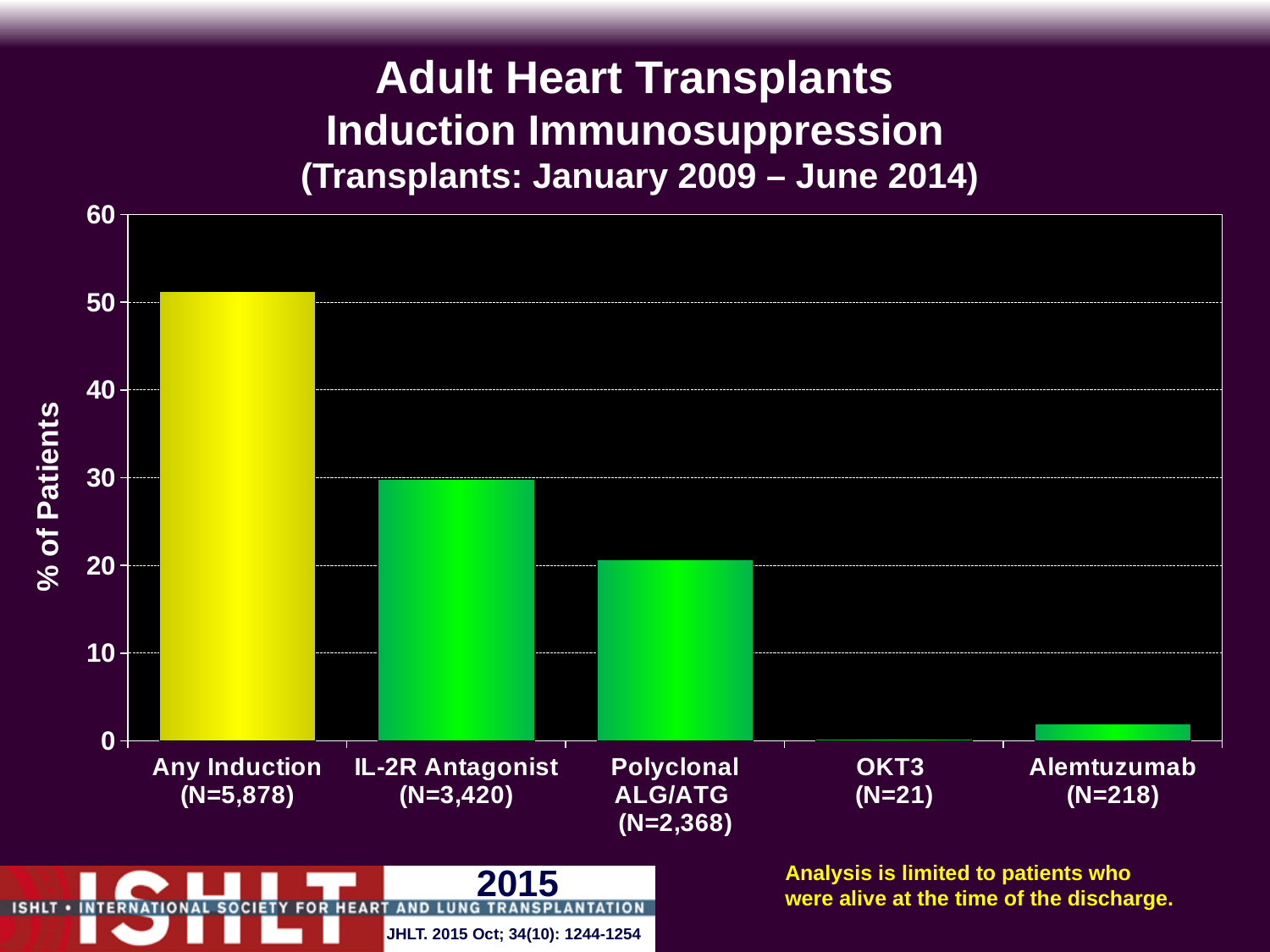
What kind of chart is shown on the slide? bar chart Is the value for Alemtuzumab greater or less than 10? less Is the value for IL-2R Antagonist greater or less than 40? less What is the label of the y axis? % of Patients Which category has the lowest percentage of patients? OKT3 Which is larger, the value for Alemtuzumab or the value for OKT3? Alemtuzumab Which category has the highest percentage of patients? Any Induction Is the value for Polyclonal ALG/ATG greater or less than 30? less Which is larger, the value for IL-2R Antagonist or the value for Polyclonal ALG/ATG? IL-2R Antagonist What is the N shown for the OKT3 category? N=21 How many categories are shown on the x axis of the chart? 5